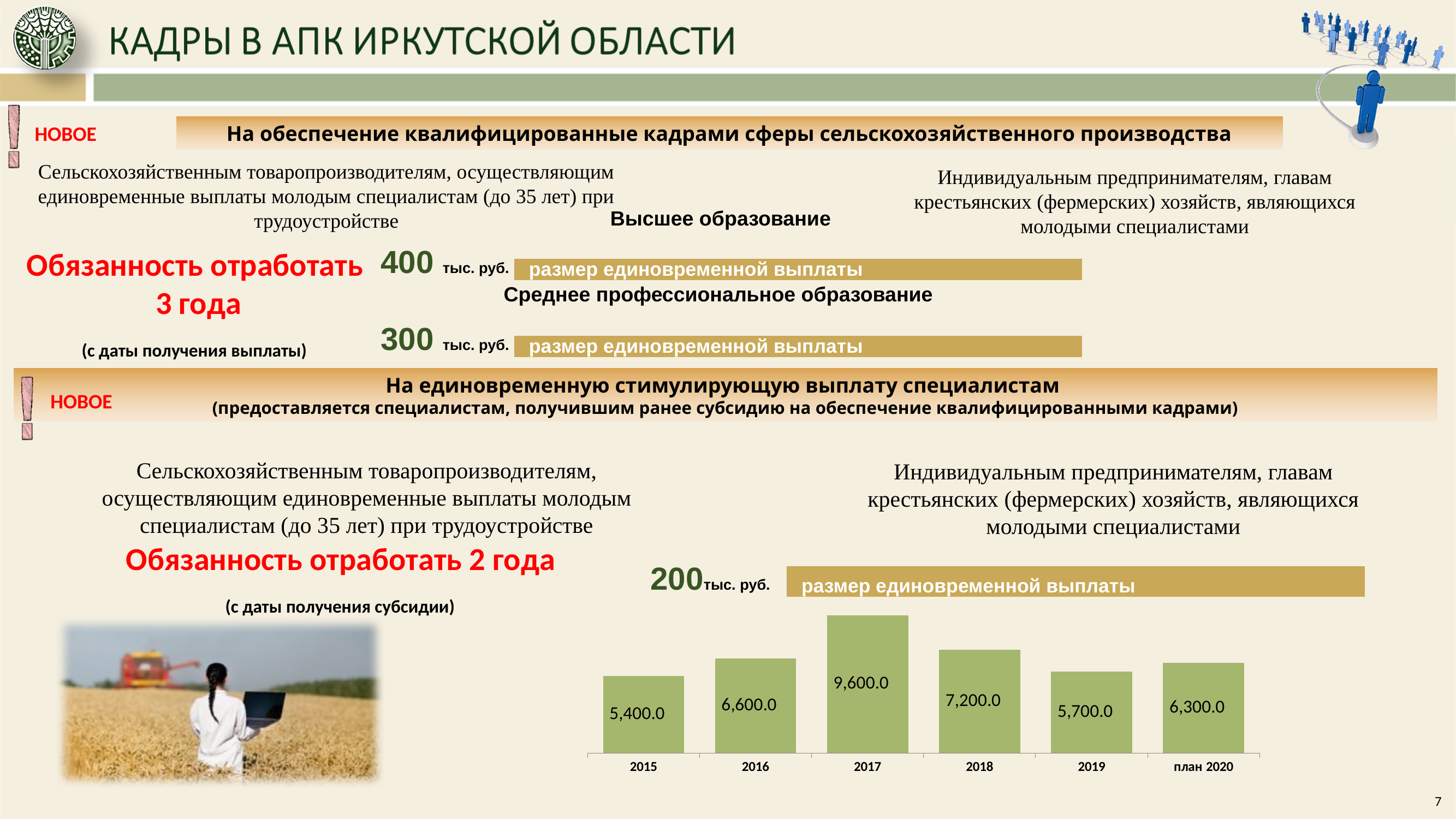
What kind of chart is shown at the bottom right of the slide? bar chart Which category has the lowest value in the bar chart? 2015 What is the difference between the values for 2016 and 2015 in the bar chart? 1,200.0 How many categories are shown in the bar chart? 6 What is the value for 2017 in the bar chart? 9,600.0 Which year has the highest value in the bar chart? 2017 What is the difference between the values for 2017 and 2018 in the bar chart? 2,400.0 Do the values in the bar chart rise or fall from 2017 to 2019? fall Which is larger in the bar chart, the value for 2018 or the value for 2019? 2018 What is the value for план 2020 in the bar chart? 6,300.0 What is the value for 2019 in the bar chart? 5,700.0 What is the value for 2015 in the bar chart? 5,400.0